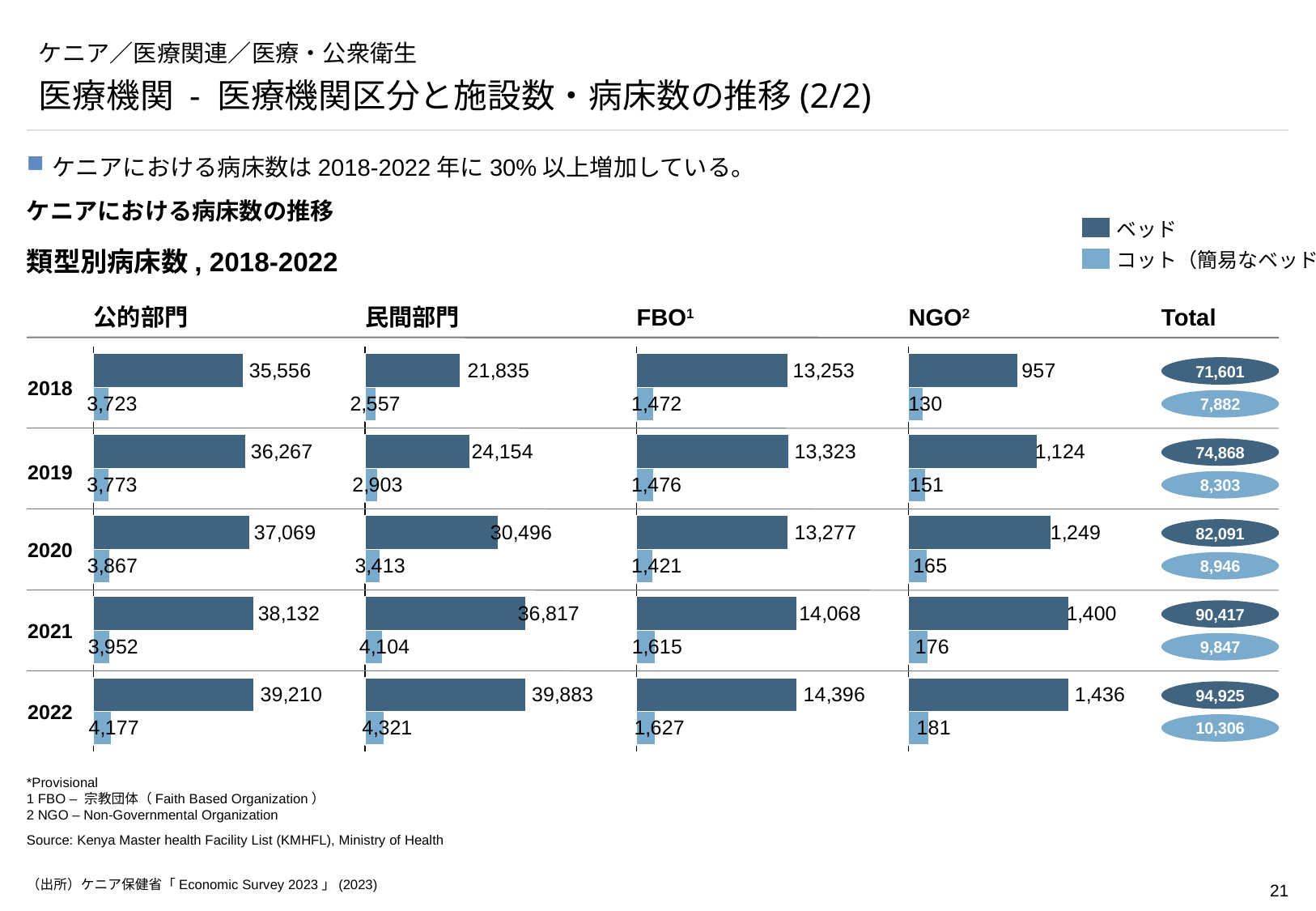
Which year has the highest Total number of ベッド (beds)? 2022 How many series does the legend list? 2 By how much did the number of ベッド (beds) for 公的部門 increase from 2018 to 2022? 3,654 Which sector has the lowest number of ベッド (beds) in 2021? NGO What is the number of ベッド (beds) for NGO in 2018? 957 What is the number of コット (cots) for 民間部門 in 2019? 2,903 What is the Total number of ベッド (beds) in 2020? 82,091 What kind of chart is used to show the bed counts? Bar chart In 2022, which sector has more ベッド (beds): 公的部門 or 民間部門? 民間部門 What is the number of コット (cots) for FBO in 2020? 1,421 Does the Total number of ベッド (beds) rise or fall from 2018 to 2022? Rise What is the number of ベッド (beds) for 公的部門 in 2022? 39,210